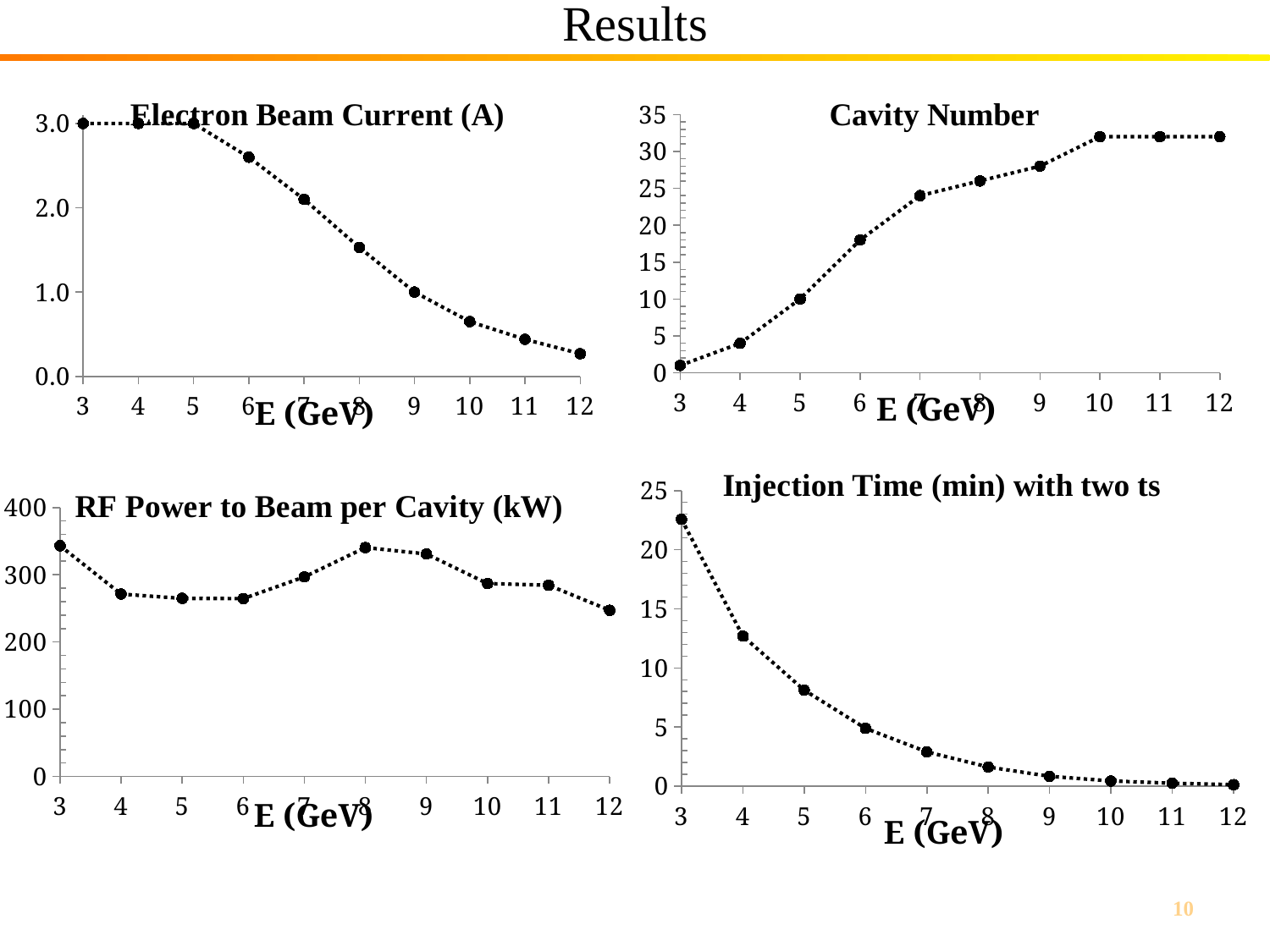
In the RF Power to Beam per Cavity (kW) chart, which is larger: the value at E = 3 GeV or at E = 4 GeV? E = 3 GeV In the RF Power to Beam per Cavity (kW) chart, is the value at E = 12 GeV greater or less than 300? less In the Electron Beam Current (A) chart, what is the value at E = 3 GeV? 3.0 How many data points are plotted on the Cavity Number chart? 10 In the Injection Time (min) with two ts chart, is the value at E = 4 GeV greater or less than 10? greater In the Cavity Number chart, what is the value at E = 5 GeV? 10 What is the x-axis label shared by all four charts on the slide? E (GeV) In the Injection Time (min) with two ts chart, at which E (GeV) is the injection time highest? 3 In the Cavity Number chart, do the values rise or fall as E increases from 3 to 12 GeV? rise What type of chart is the Electron Beam Current (A) chart? line chart In the Electron Beam Current (A) chart, what is the value at E = 9 GeV? 1.0 In the Injection Time (min) with two ts chart, do the values rise or fall as E increases? fall